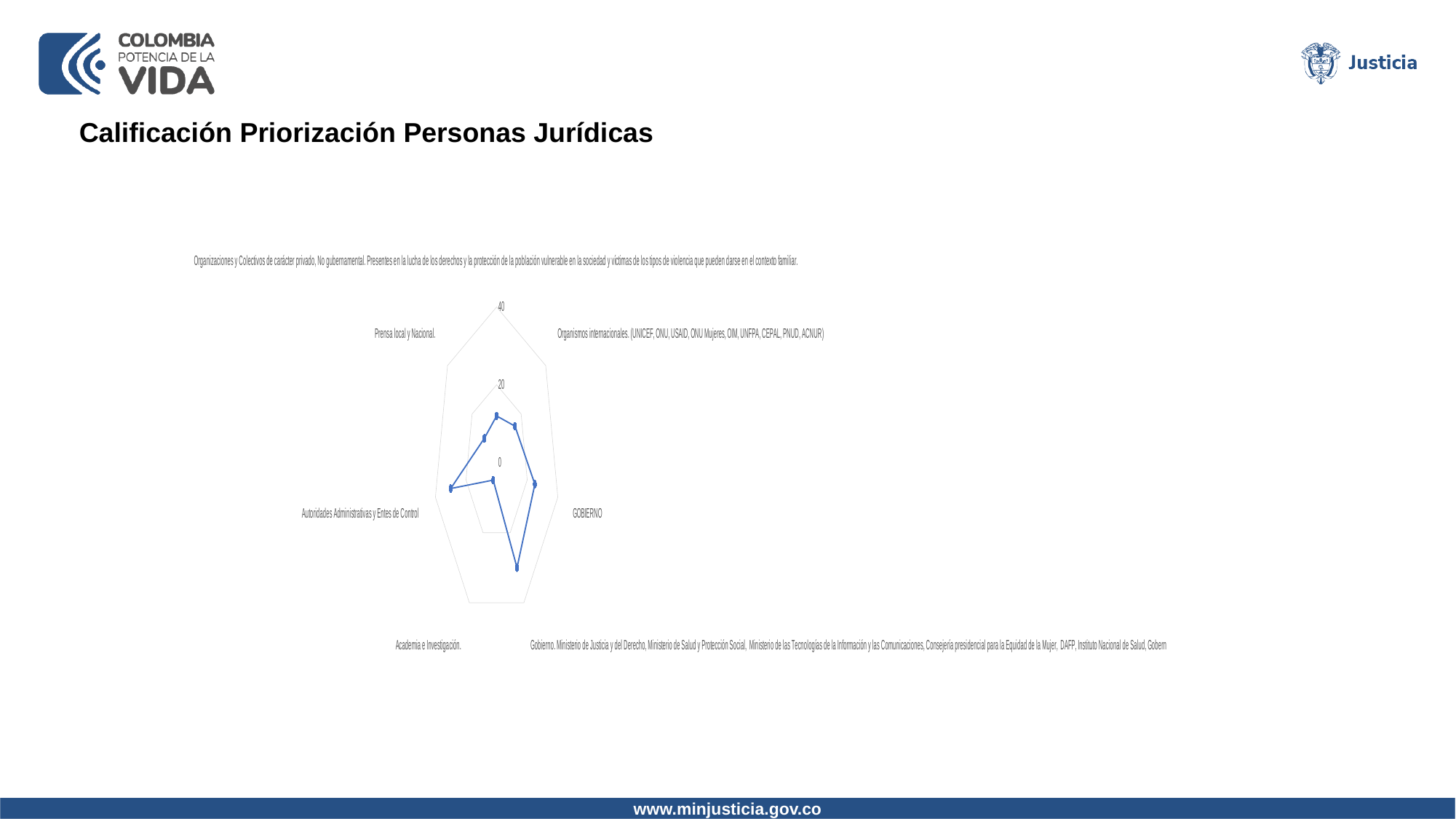
What kind of chart is shown on the slide? Radar chart Which has the larger value: Autoridades Administrativas y Entes de Control or Academia e Investigación? Autoridades Administrativas y Entes de Control What is the title of the slide containing the chart? Calificación Priorización Personas Jurídicas Is the value for Autoridades Administrativas y Entes de Control greater or less than 20? greater How many categories (axes) does the radar chart have? 7 Is the value for Prensa local y Nacional greater or less than 20? less What is the maximum value shown on the radar chart's axis scale? 40 Which category has the lowest value in the radar chart? Academia e Investigación. Is the value for Academia e Investigación greater or less than 20? less Which has the larger value: Organizaciones y Colectivos de carácter privado or GOBIERNO? GOBIERNO